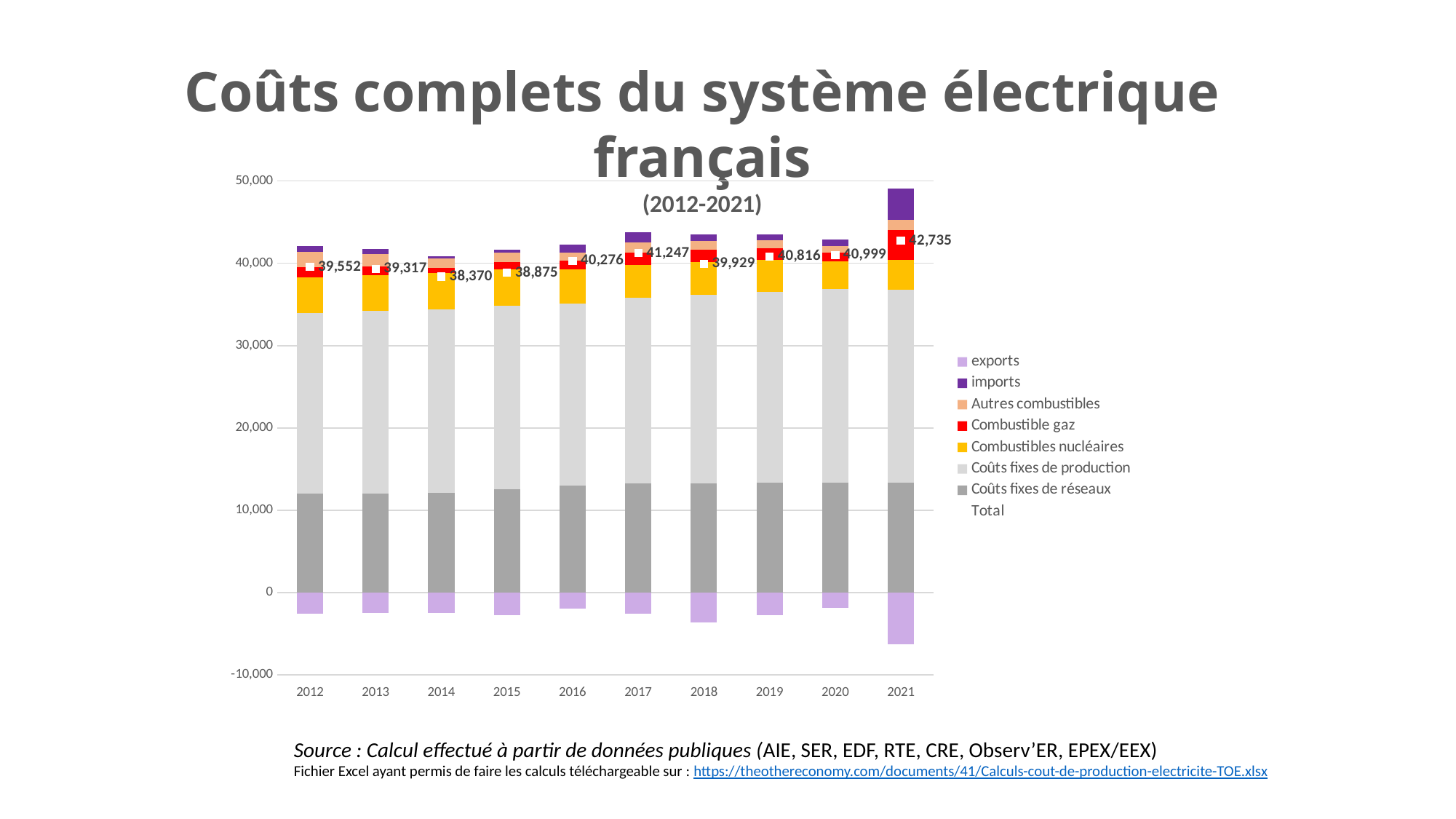
How many entries does the legend list? 8 Does the Total value rise or fall from 2012 to 2014? Fall What is the Total value shown for 2017? 41,247 Which year has a larger Total value, 2016 or 2018? 2016 What is the Total value shown for 2021? 42,735 Which year has the highest Total value? 2021 What kind of chart is shown on the slide? Stacked bar chart Which year has the lowest Total value? 2014 How many years are shown on the x axis? 10 What is the difference between the Total values for 2021 and 2012? 3,183 Is the value for Coûts fixes de réseaux in 2012 greater or less than 10,000? greater What is the Total value shown for 2012? 39,552